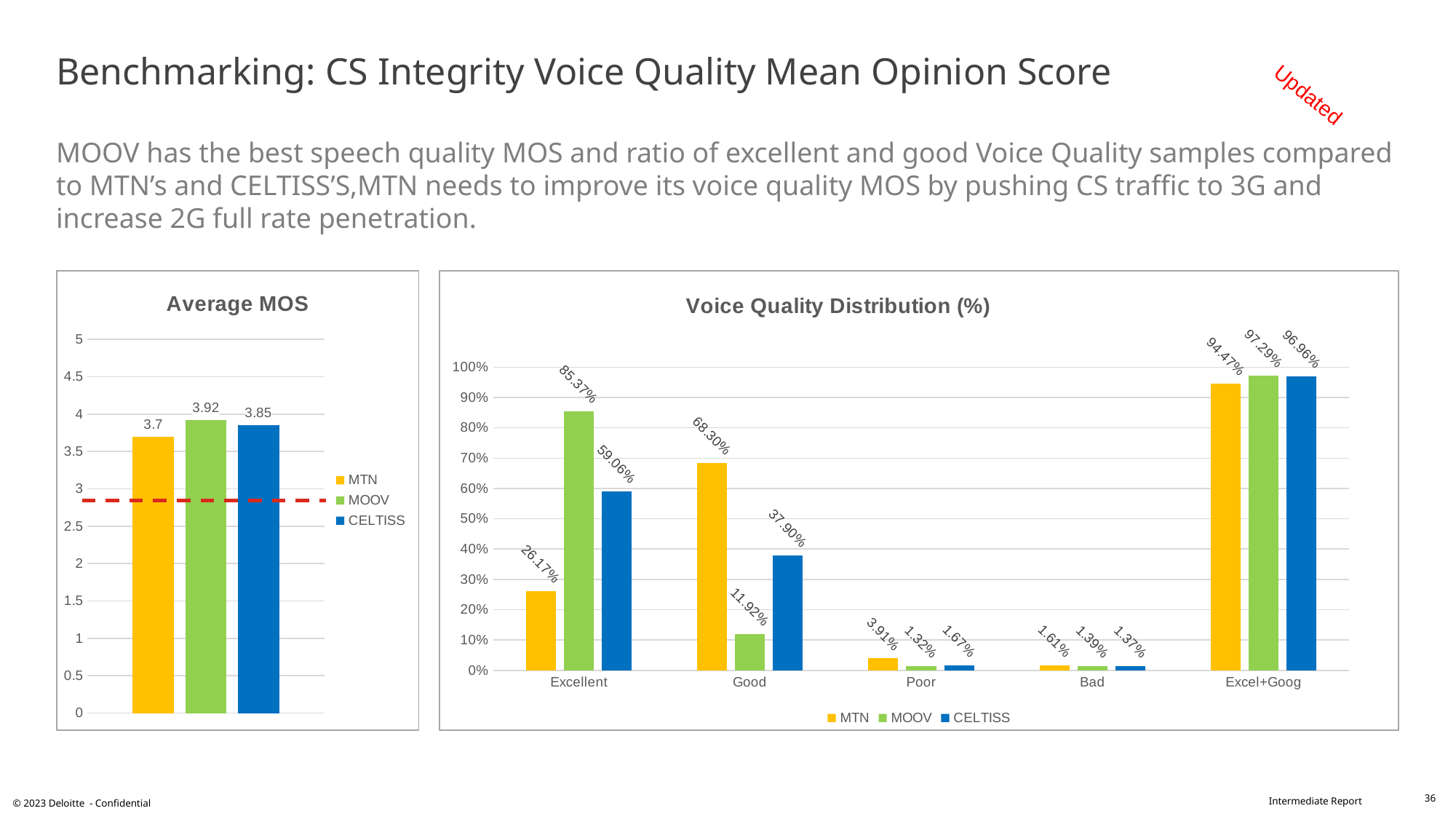
In the Voice Quality Distribution (%) chart, which is larger in the Excel+Goog category: MOOV or CELTISS? MOOV In the Voice Quality Distribution (%) chart, how many categories are shown on the x axis? 5 In the Average MOS chart, how many series does the legend list? 3 In the Average MOS chart, what colour is the CELTISS bar? Blue In the Voice Quality Distribution (%) chart, what is the value for MOOV in the Excellent category? 85.37% What kind of chart is the Voice Quality Distribution (%) chart? Bar chart In the Voice Quality Distribution (%) chart, what is the value for CELTISS in the Good category? 37.90% In the Average MOS chart, which operator has the lowest average MOS? MTN In the Voice Quality Distribution (%) chart, which operator has the highest value in the Poor category? MTN In the Voice Quality Distribution (%) chart, what is the difference between MTN's and MOOV's values in the Good category? 56.38% In the Average MOS chart, what is the value for MOOV? 3.92 In the Average MOS chart, what is the difference between MOOV's and MTN's values? 0.22